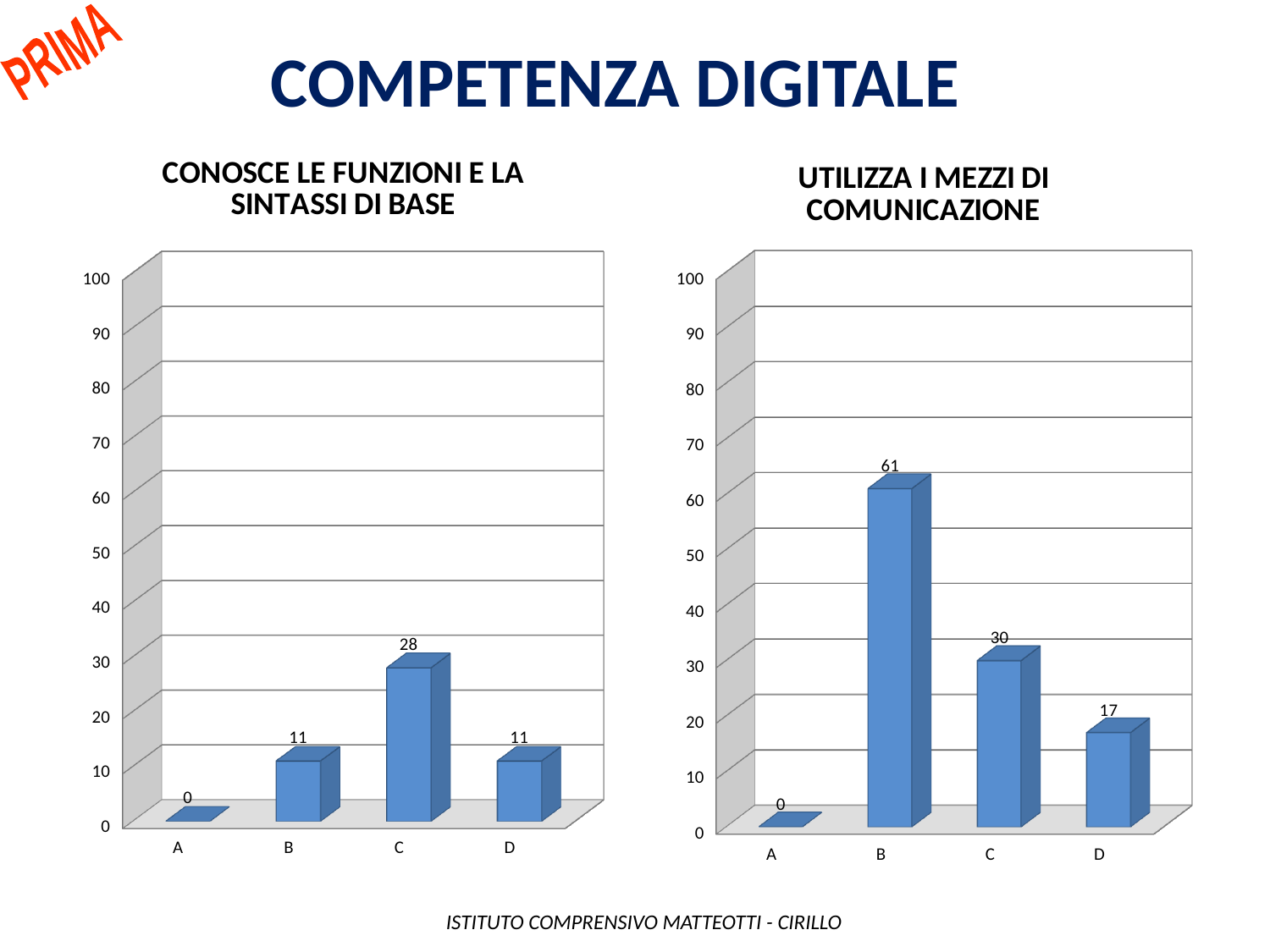
How many categories are shown in the chart titled 'CONOSCE LE FUNZIONI E LA SINTASSI DI BASE'? 4 What kind of chart is the chart titled 'UTILIZZA I MEZZI DI COMUNICAZIONE'? bar chart In the chart titled 'UTILIZZA I MEZZI DI COMUNICAZIONE', what is the difference between the values for B and C? 31 In the chart titled 'CONOSCE LE FUNZIONI E LA SINTASSI DI BASE', what is the difference between the values for C and D? 17 In the chart titled 'UTILIZZA I MEZZI DI COMUNICAZIONE', is the value for B greater or less than 50? greater In the chart titled 'CONOSCE LE FUNZIONI E LA SINTASSI DI BASE', which category has the lowest value? A In the chart titled 'UTILIZZA I MEZZI DI COMUNICAZIONE', what is the value for category B? 61 In the chart titled 'UTILIZZA I MEZZI DI COMUNICAZIONE', which category has the highest value? B In the chart titled 'UTILIZZA I MEZZI DI COMUNICAZIONE', what is the value for category D? 17 In the chart titled 'UTILIZZA I MEZZI DI COMUNICAZIONE', which is larger, the value for C or the value for D? C In the chart titled 'CONOSCE LE FUNZIONI E LA SINTASSI DI BASE', what is the value for category B? 11 In the chart titled 'CONOSCE LE FUNZIONI E LA SINTASSI DI BASE', what is the value for category C? 28